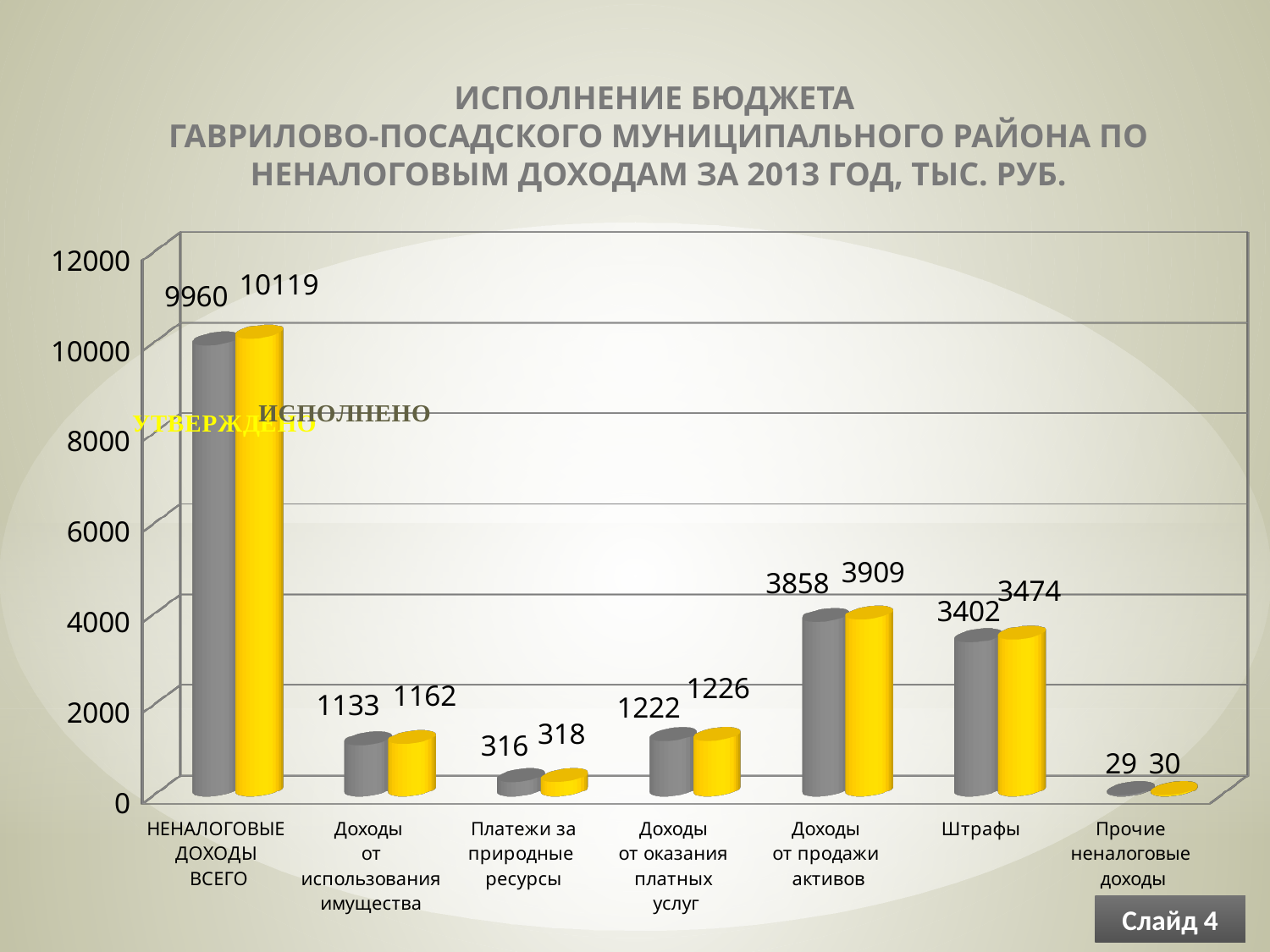
Excluding НЕНАЛОГОВЫЕ ДОХОДЫ ВСЕГО, which category has the highest ИСПОЛНЕНО value? Доходы от продажи активов How many categories are shown on the x axis? 7 How many series does the chart show? 2 What kind of chart is shown on the slide? bar chart What is the difference between the ИСПОЛНЕНО and УТВЕРЖДЕНО values for Штрафы? 72 Is the ИСПОЛНЕНО value for Доходы от продажи активов greater or less than 4000? less Which is larger: the УТВЕРЖДЕНО value for Доходы от использования имущества or the УТВЕРЖДЕНО value for Доходы от оказания платных услуг? Доходы от оказания платных услуг What is the УТВЕРЖДЕНО value for Штрафы? 3402 Which category has the lowest УТВЕРЖДЕНО value? Прочие неналоговые доходы What is the ИСПОЛНЕНО value for НЕНАЛОГОВЫЕ ДОХОДЫ ВСЕГО? 10119 What is the ИСПОЛНЕНО value for Доходы от продажи активов? 3909 What is the difference between the ИСПОЛНЕНО and УТВЕРЖДЕНО values for НЕНАЛОГОВЫЕ ДОХОДЫ ВСЕГО? 159